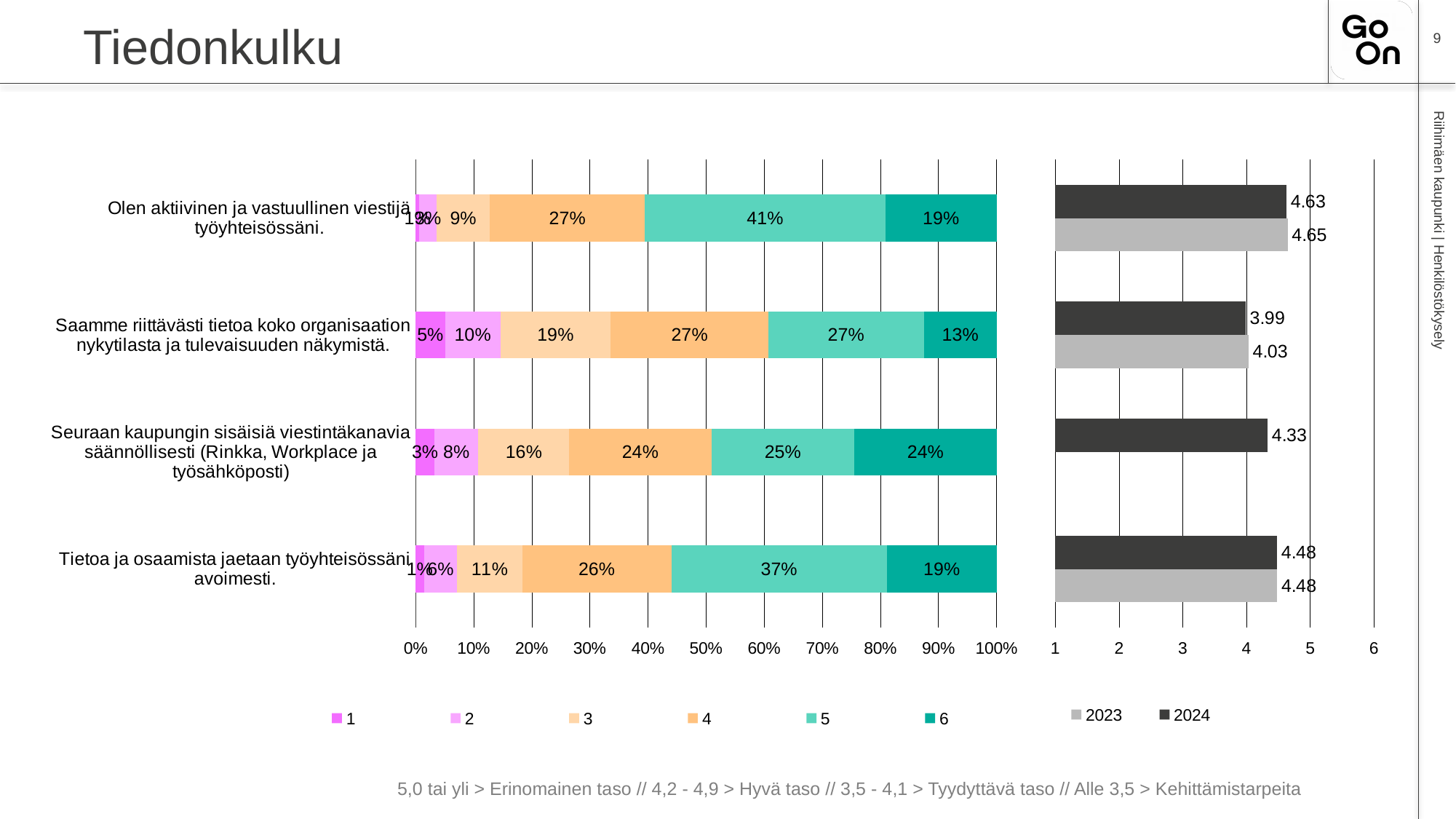
In the left stacked bar chart, how many statements are shown? 4 In the right chart, what is the 2024 value for "Saamme riittävästi tietoa koko organisaation nykytilasta ja tulevaisuuden näkymistä."? 3.99 In the left stacked bar chart, how many rating categories does the legend list? 6 In the left stacked bar chart, what percentage of respondents gave a rating of 5 for "Olen aktiivinen ja vastuullinen viestijä työyhteisössäni."? 41% In the left stacked bar chart, which rating category has the largest share for "Tietoa ja osaamista jaetaan työyhteisössäni avoimesti."? 5 In the right chart, what is the 2023 value for "Olen aktiivinen ja vastuullinen viestijä työyhteisössäni."? 4.65 In the left stacked bar chart, what percentage gave a rating of 6 for "Seuraan kaupungin sisäisiä viestintäkanavia säännöllisesti (Rinkka, Workplace ja työsähköposti)"? 24% What type of chart is the right chart? Bar chart In the left stacked bar chart, what is the difference between the share of rating 4 and the share of rating 3 for "Tietoa ja osaamista jaetaan työyhteisössäni avoimesti."? 15% In the right chart, what is the difference between the 2023 and 2024 values for "Saamme riittävästi tietoa koko organisaation nykytilasta ja tulevaisuuden näkymistä."? 0.04 In the right chart, which statement has the lowest 2024 value? Saamme riittävästi tietoa koko organisaation nykytilasta ja tulevaisuuden näkymistä. In the left stacked bar chart, what percentage gave a rating of 1 for "Saamme riittävästi tietoa koko organisaation nykytilasta ja tulevaisuuden näkymistä."? 5%